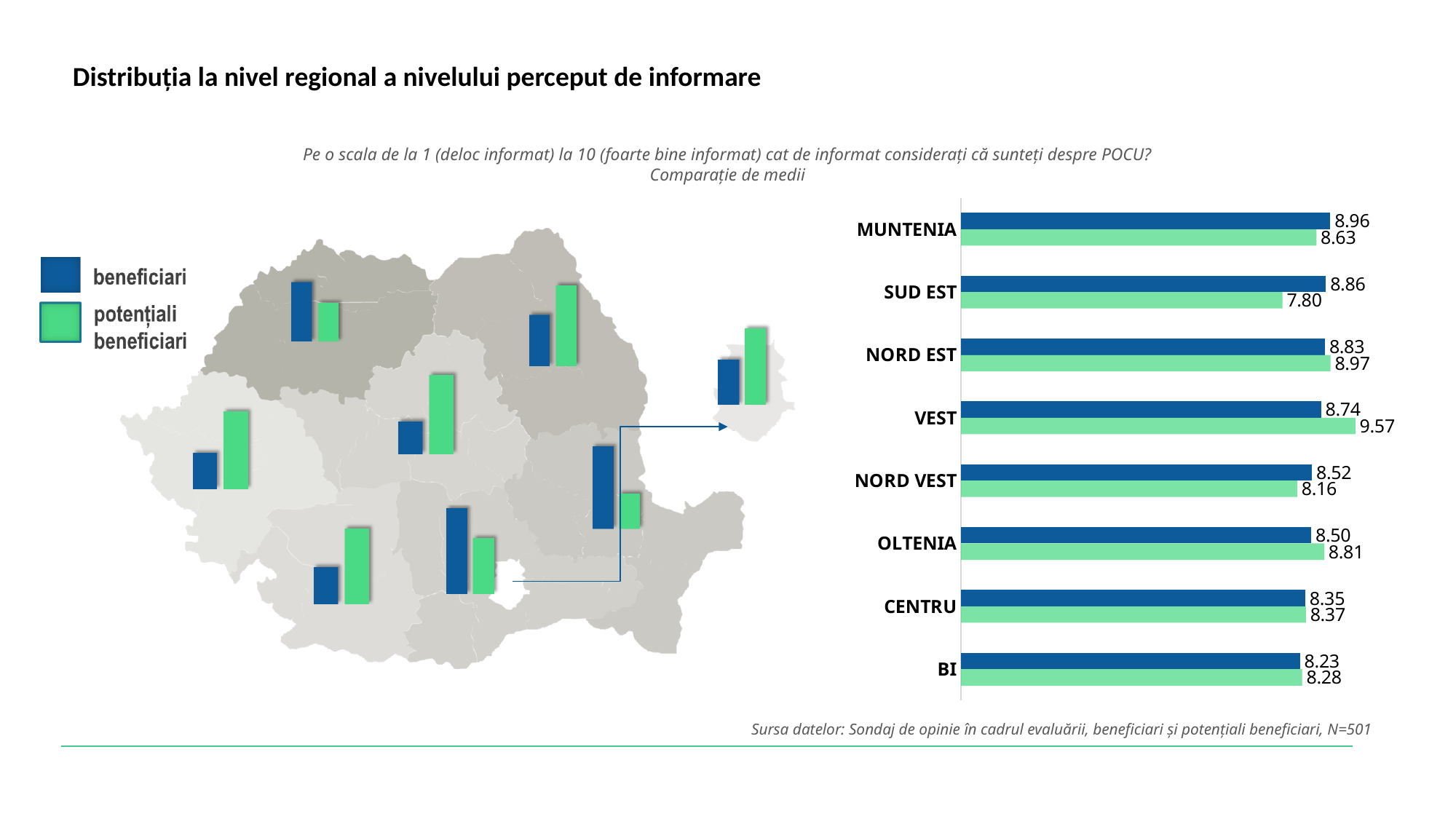
What is the value for beneficiari in MUNTENIA? 8.96 What is the difference between the beneficiari and potențiali beneficiari values in SUD EST? 1.06 How many series does the legend list? 2 Which region has the lowest value for potențiali beneficiari? SUD EST How many regions are shown in the bar chart? 8 What is the value for beneficiari in BI? 8.23 What is the value for potențiali beneficiari in SUD EST? 7.80 Which region has the highest value for beneficiari? MUNTENIA What kind of chart is shown on the right side of the slide? bar chart Which colour represents potențiali beneficiari in the chart? green What is the value for potențiali beneficiari in VEST? 9.57 In NORD EST, which is larger: the beneficiari value or the potențiali beneficiari value? potențiali beneficiari